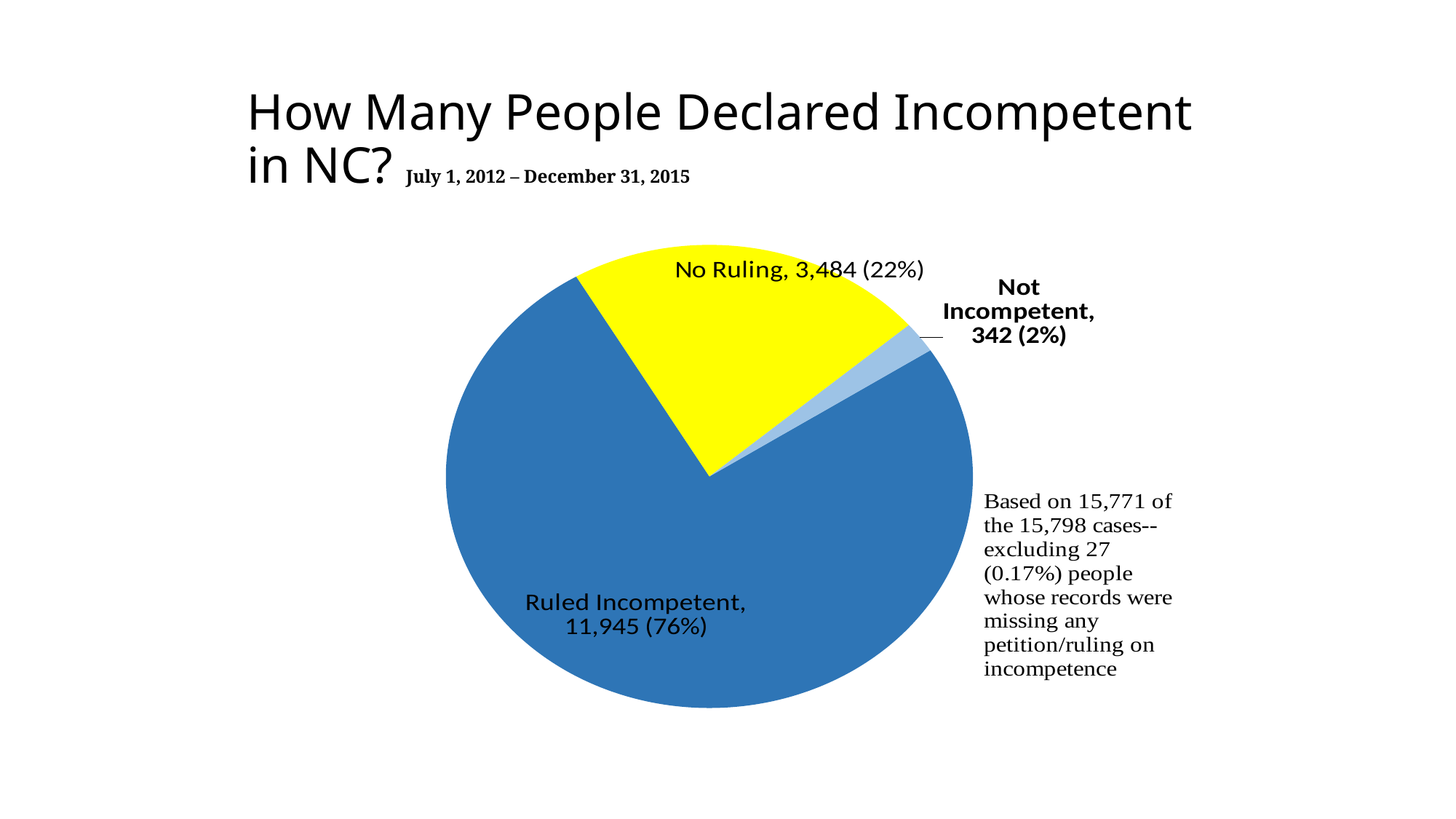
Which category has the largest slice? Ruled Incompetent Which is larger, the No Ruling count or the Not Incompetent count? No Ruling How many people were Ruled Incompetent? 11,945 What share of the pie is the Ruled Incompetent slice? 76% How many cases had No Ruling? 3,484 What is the difference between the Ruled Incompetent count and the No Ruling count? 8,461 What share of the pie is the No Ruling slice? 22% How many people were found Not Incompetent? 342 Which category has the smallest slice? Not Incompetent What kind of chart is shown on the slide? pie chart How many slices does the pie chart have? 3 What colour is the No Ruling slice? yellow